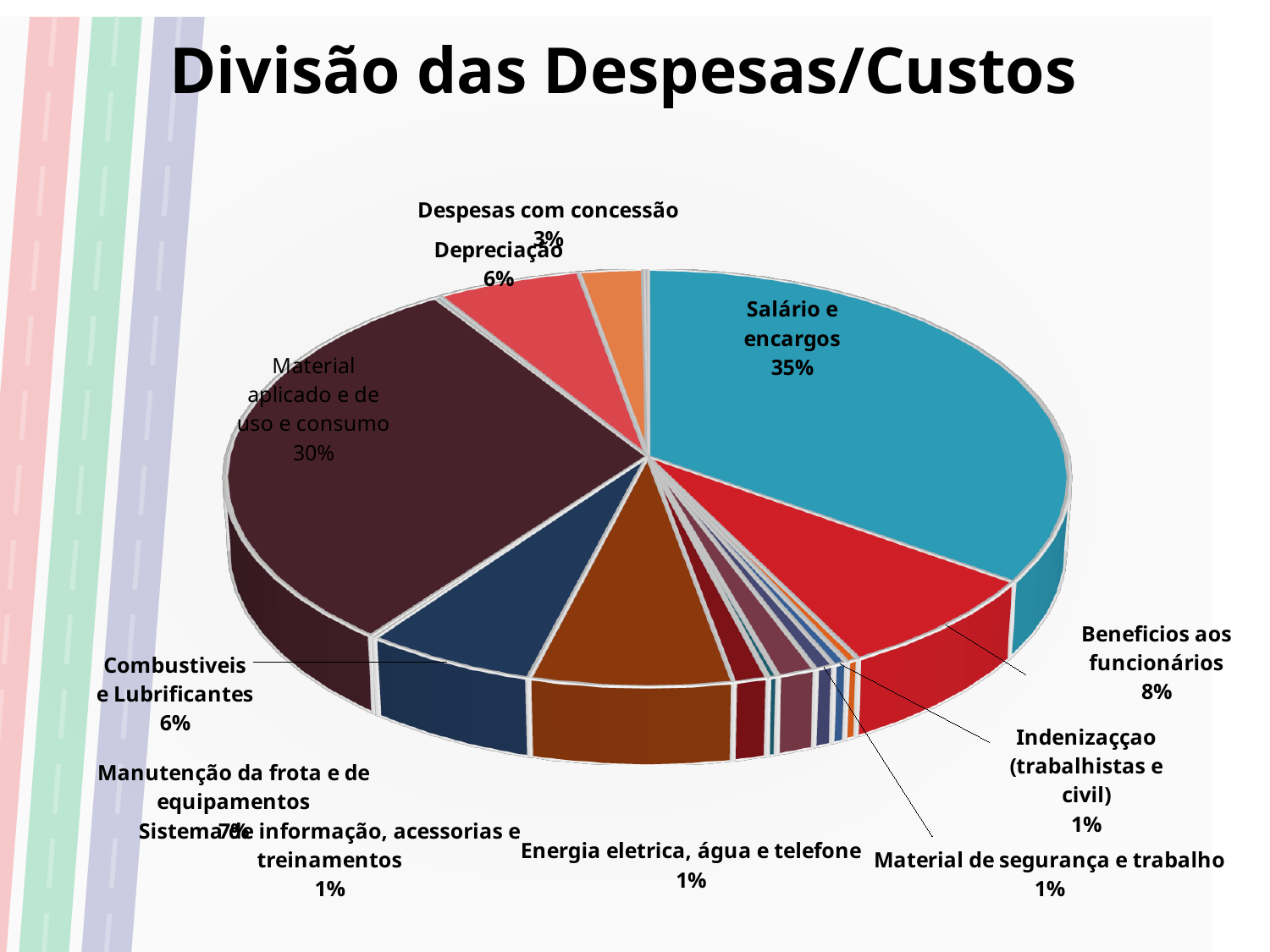
What share of the pie does Salário e encargos represent? 35% What is the difference in percentage points between Salário e encargos and Material aplicado e de uso e consumo? 5 What is the difference in percentage points between Beneficios aos funcionários and Manutenção da frota e de equipamentos? 1 What percentage is shown for Manutenção da frota e de equipamentos? 7% What percentage is shown for Material aplicado e de uso e consumo? 30% Which category has the largest share of the pie? Salário e encargos What percentage is shown for Energia eletrica, água e telefone? 1% What percentage is shown for Despesas com concessão? 3% What is the title of the chart? Divisão das Despesas/Custos What percentage is shown for Beneficios aos funcionários? 8% Which is larger, Depreciação or Despesas com concessão? Depreciação What type of chart is shown on the slide? pie chart